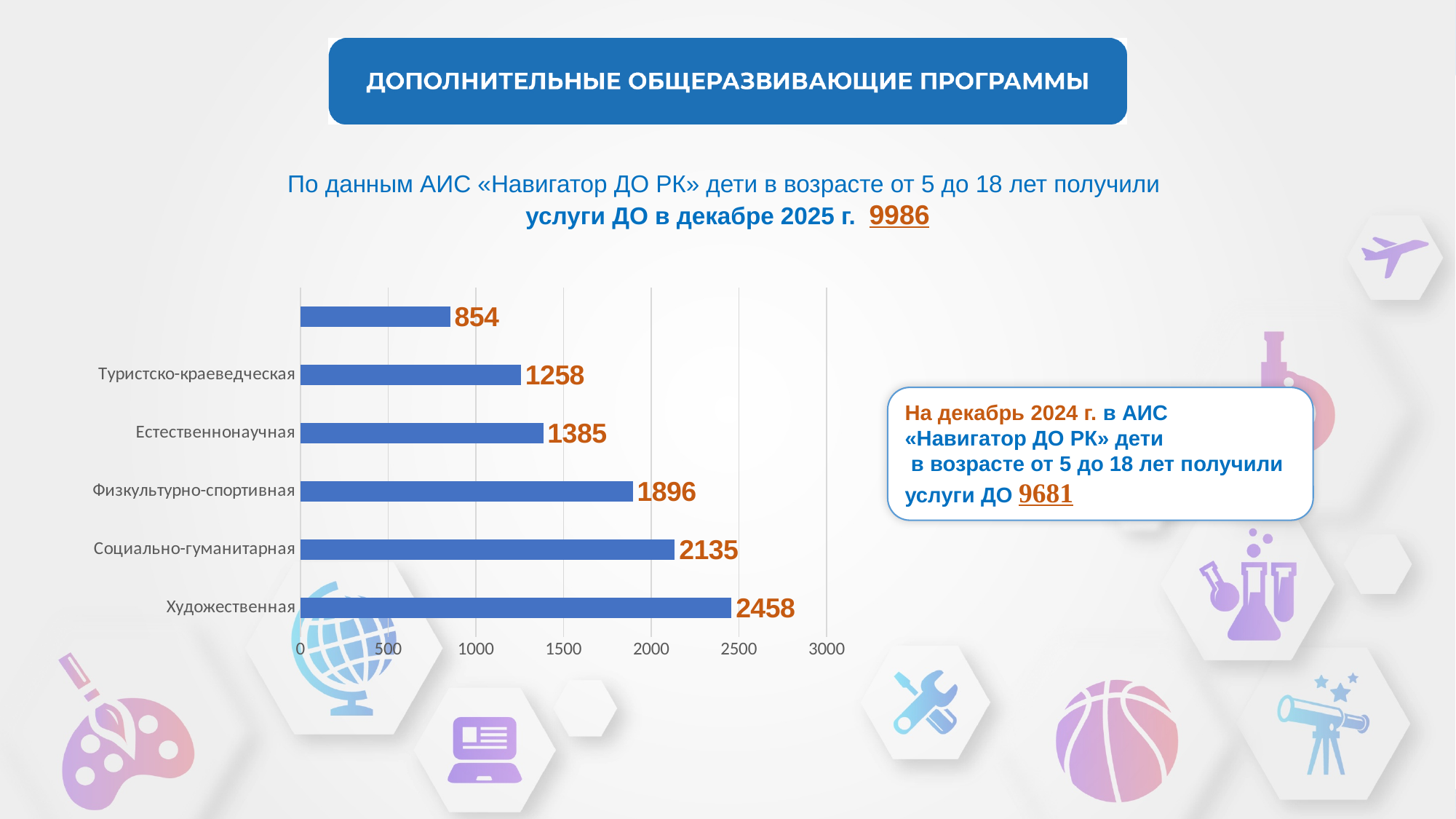
Which labelled category has the highest value? Художественная What is the value for Естественнонаучная? 1385 What is the value for Туристско-краеведческая? 1258 What is the value for Художественная? 2458 How many bars are plotted in the chart? 6 What is the value for Социально-гуманитарная? 2135 What type of chart is shown on the slide? bar chart Is the value for Физкультурно-спортивная greater or less than 2000? less What is the difference between the values for Художественная and Социально-гуманитарная? 323 What is the smallest value shown on any bar in the chart? 854 Which is larger, the value for Естественнонаучная or the value for Туристско-краеведческая? Естественнонаучная What is the value for Физкультурно-спортивная? 1896